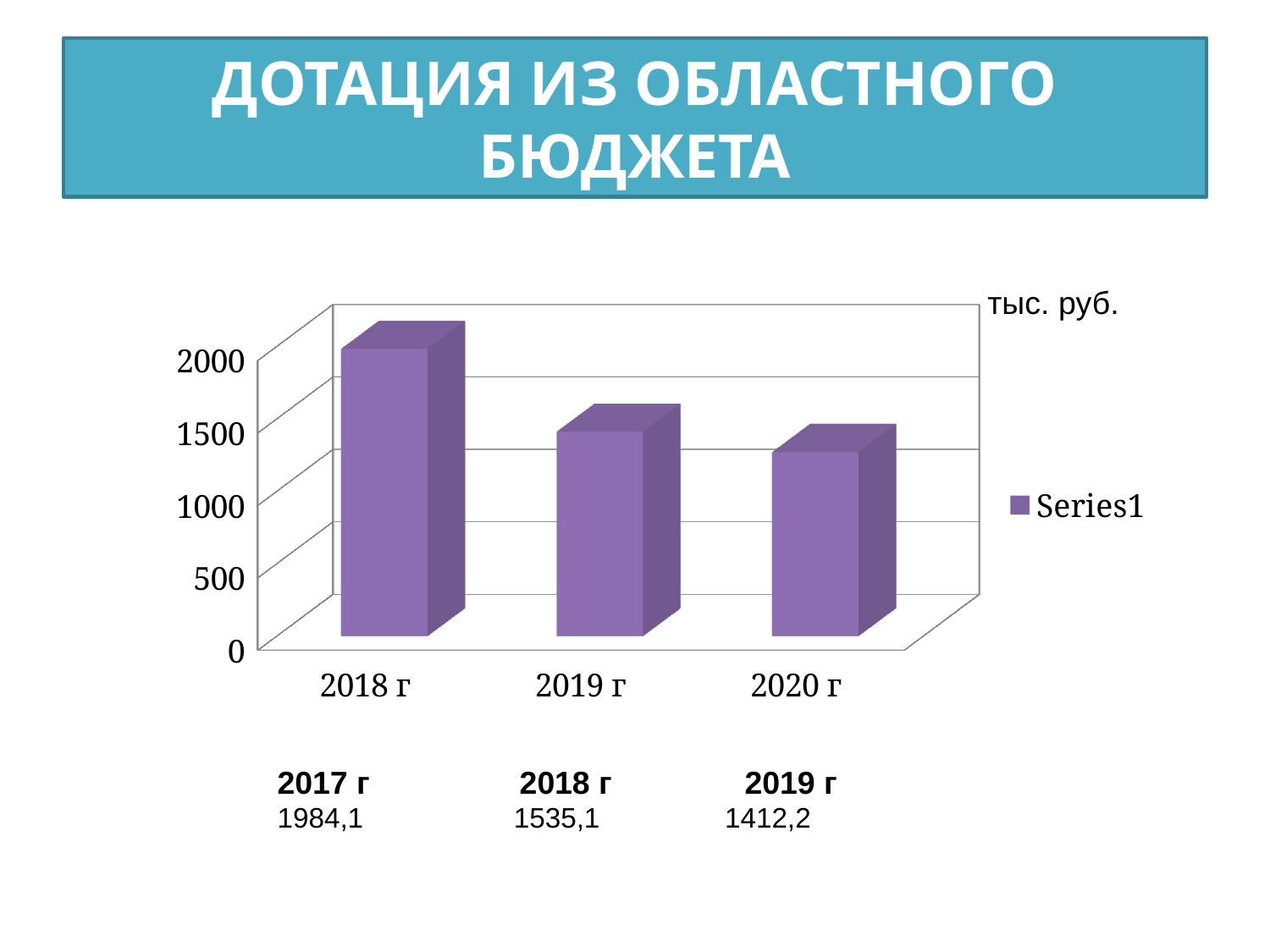
Do the values rise or fall from 2018 г to 2020 г? fall What kind of chart is shown on the slide? bar chart How many bars (categories) does the chart show? 3 Is the value for 2019 г greater or less than 2000? less What is the name of the series shown in the legend? Series1 What unit label is shown at the top right of the chart? тыс. руб. Which is larger, the value for 2019 г or the value for 2020 г? 2019 г How many series does the legend list? 1 Which category has the highest bar? 2018 г Is the value for 2020 г greater or less than 1000? greater Which category has the lowest bar? 2020 г Is the value for 2018 г greater or less than 1500? greater